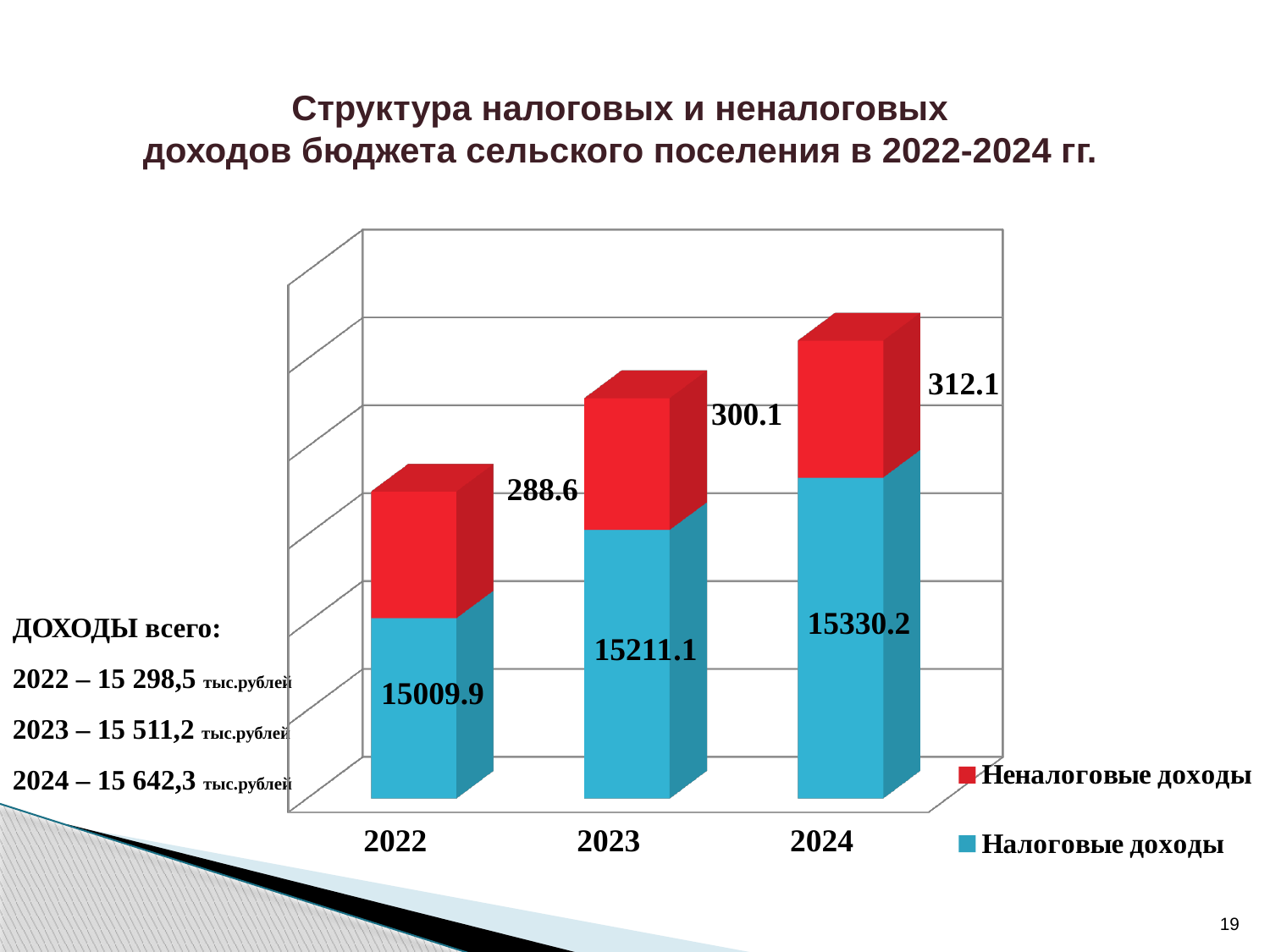
How many years are shown on the x axis? 3 Which year has the lowest value of Неналоговые доходы? 2022 Which year has the highest value of Налоговые доходы? 2024 Which is larger: Налоговые доходы in 2023 or in 2022? 2023 What is the value of Неналоговые доходы for 2023? 300.1 How many series does the legend list? 2 What is the value of Неналоговые доходы for 2024? 312.1 What is the difference between Неналоговые доходы in 2024 and in 2022? 23.5 Do the values of Налоговые доходы rise or fall from 2022 to 2024? Rise What is the value of Налоговые доходы for 2022? 15009.9 What is the difference between Налоговые доходы in 2024 and in 2022? 320.3 What kind of chart is shown on the slide? Stacked bar chart